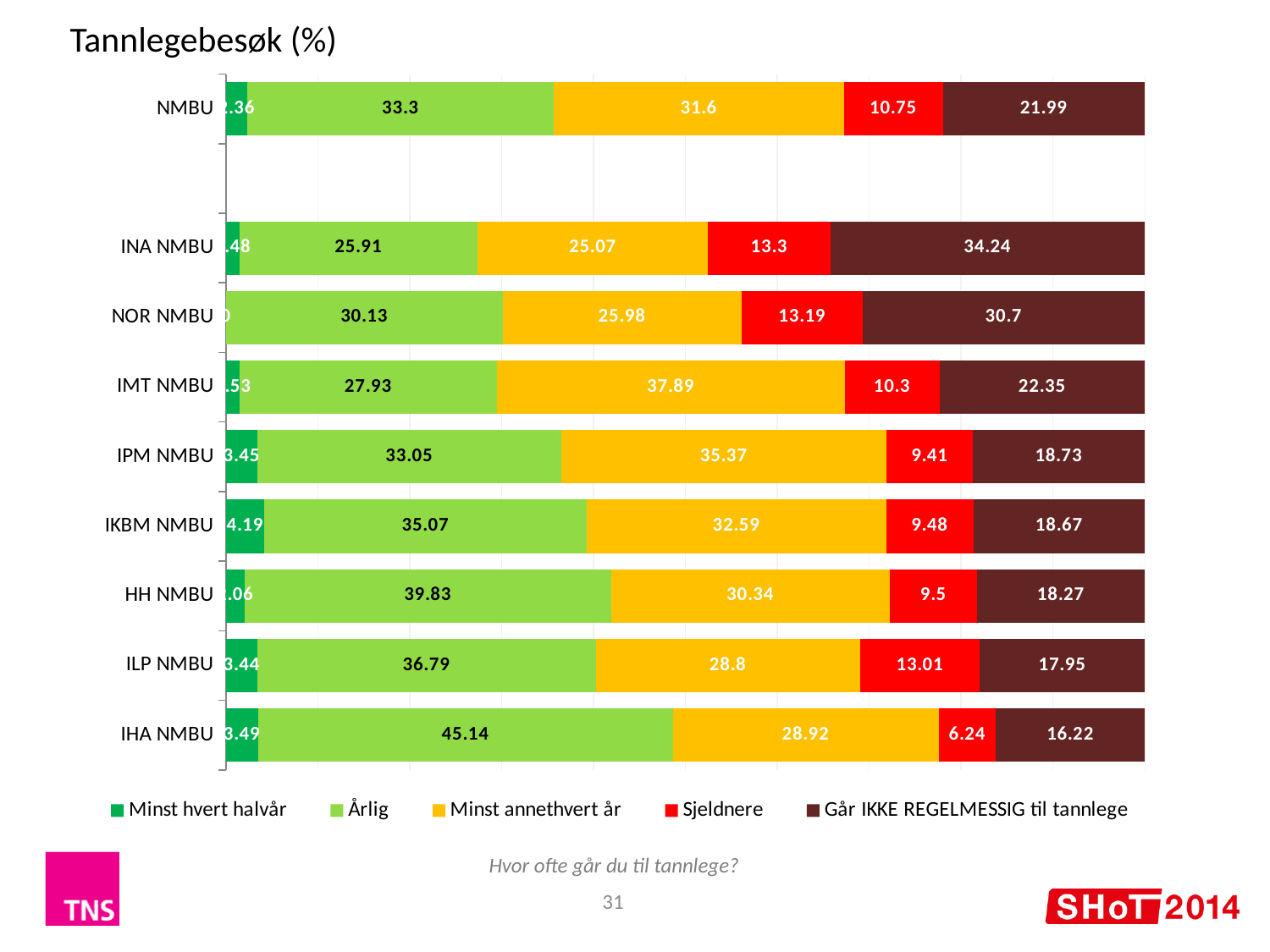
How many series does the legend list? 5 Which category has the highest value for "Årlig"? IHA NMBU What is the difference between the "Går IKKE REGELMESSIG til tannlege" values for INA NMBU and IHA NMBU? 18.02 How many categories are shown on the chart? 9 What is the value of "Sjeldnere" for IHA NMBU? 6.24 Which has the larger "Årlig" value, HH NMBU or ILP NMBU? HH NMBU What is the value of "Årlig" for IHA NMBU? 45.14 Which category has the lowest value for "Går IKKE REGELMESSIG til tannlege"? IHA NMBU Which category has the highest value for "Minst annethvert år"? IMT NMBU What is the value of "Minst annethvert år" for NMBU? 31.6 What kind of chart is shown on the slide? Stacked bar chart What is the value of "Går IKKE REGELMESSIG til tannlege" for INA NMBU? 34.24